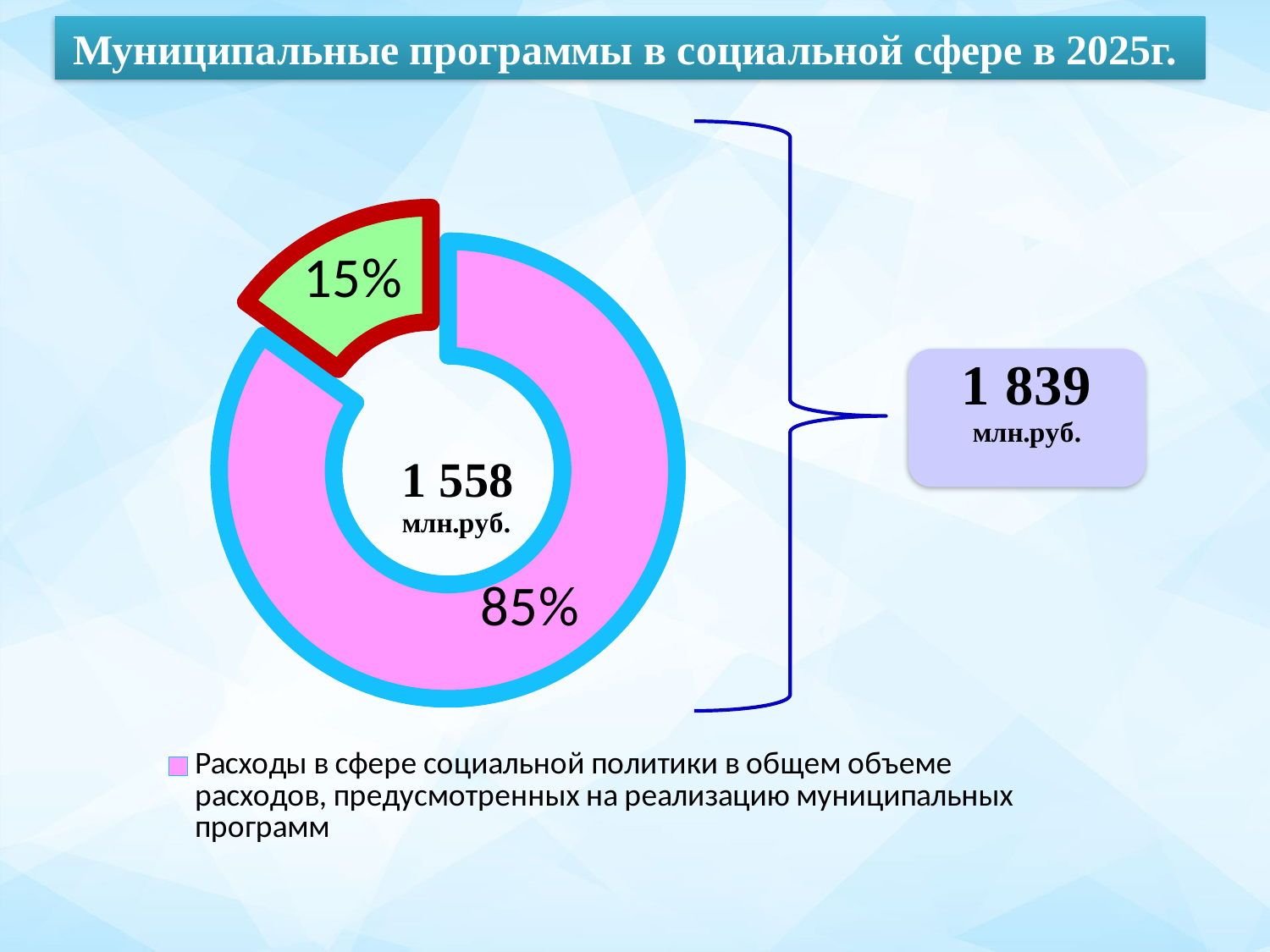
What is the title of the slide containing the chart? Муниципальные программы в социальной сфере в 2025г. By how many percentage points does the pink slice exceed the green slice? 70 percentage points What share of the doughnut chart does the green slice represent? 15% Which slice of the doughnut chart is the largest? The pink slice (85%) How many slices does the doughnut chart have? 2 What kind of chart is shown on the slide? Doughnut (pie) chart Which is larger: the pink slice or the green slice? The pink slice What value is printed in the centre of the doughnut chart? 1 558 млн.руб. What share of the doughnut chart does the pink slice (Расходы в сфере социальной политики) represent? 85% Which slice of the doughnut chart is the smallest? The green slice (15%) How many entries does the legend list? 1 What total value is shown in the box to the right of the chart? 1 839 млн.руб.